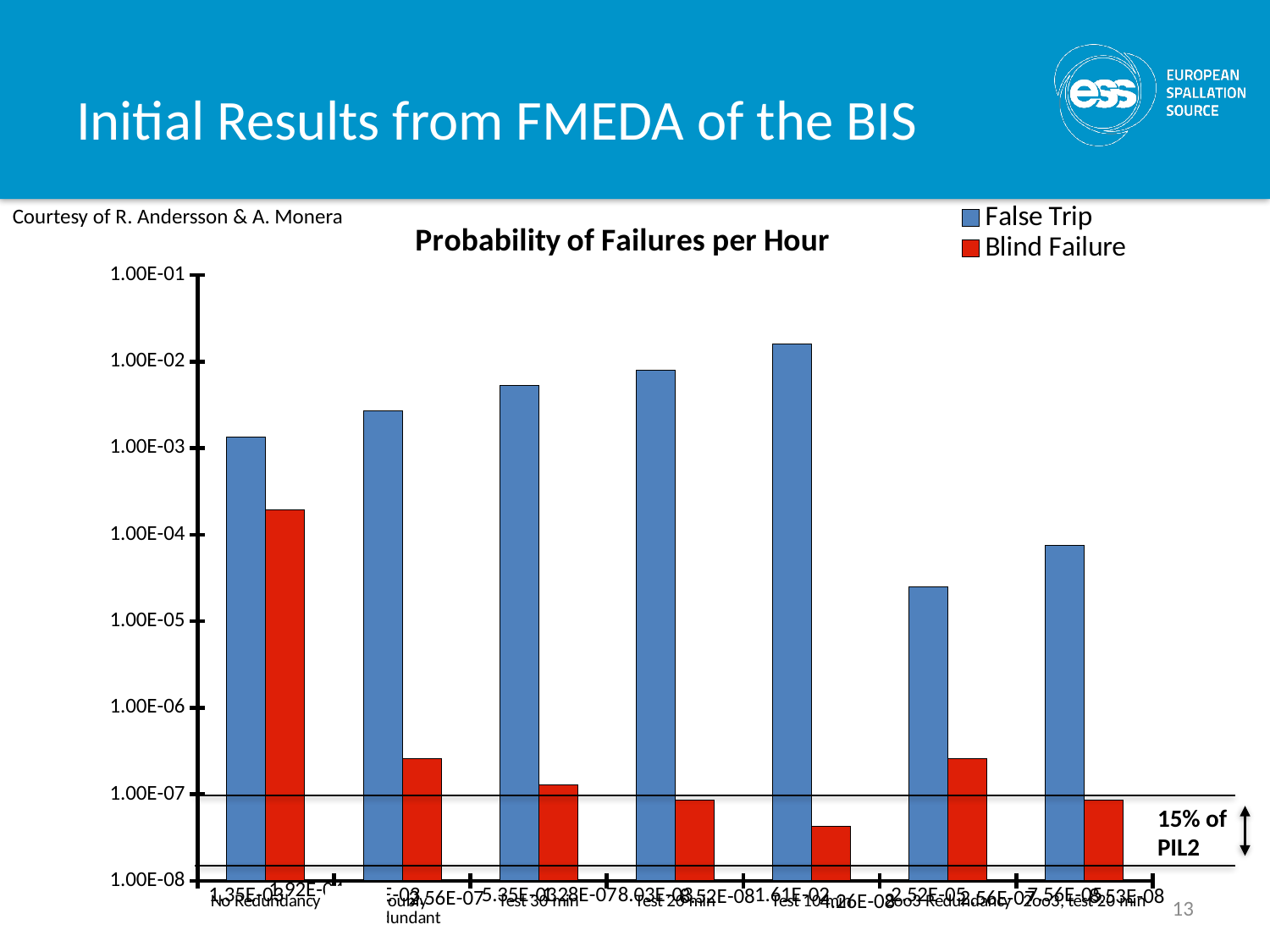
Which category has the highest Blind Failure value? No Redundancy Which category has the lowest False Trip value? 2oo3 Redundancy Which is larger, the False Trip value for Test 30 min or for Test 20 min? Test 20 min How many series does the legend list? 2 Which colour represents the Blind Failure series? red What kind of chart is shown on the slide? bar chart Which category has the highest False Trip value? Test 10 min Is the False Trip value for Test 10 min greater or less than 1.00E-02? greater How many categories are plotted along the x axis? 7 Is the Blind Failure value for Test 10 min greater or less than 1.00E-07? less Which category has the lowest Blind Failure value? Test 10 min Do the False Trip values rise or fall from No Redundancy through Test 10 min? rise